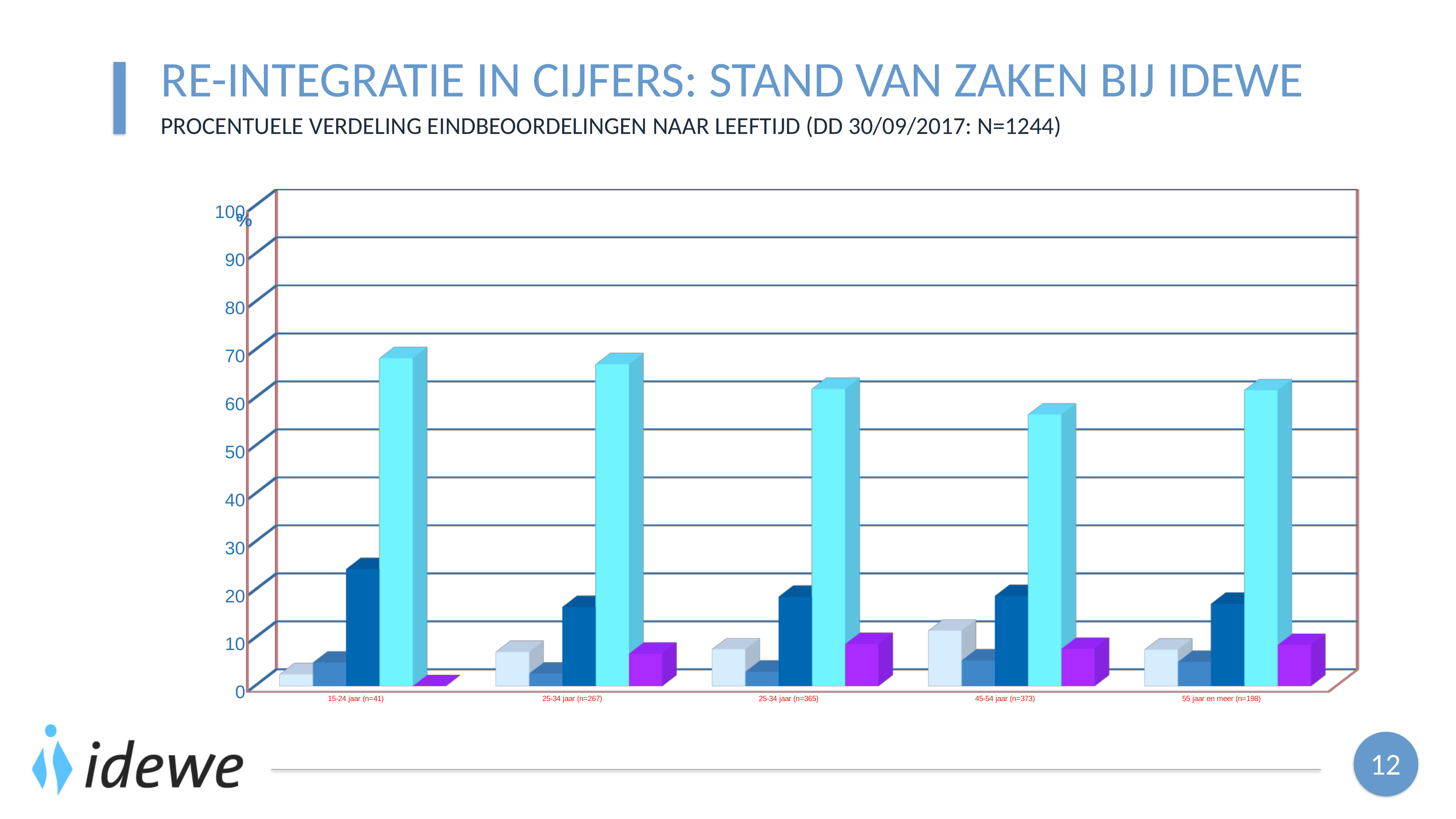
How many bars are plotted for each age category in the chart? 5 Which is larger: the cyan bar for 15-24 jaar (n=41) or the cyan bar for 45-54 jaar (n=373)? 15-24 jaar (n=41) Which age category has the lowest purple bar? 15-24 jaar (n=41) Is the cyan bar for 15-24 jaar (n=41) greater or less than 60? greater How many age categories are shown along the x axis of the chart? 5 Which age category has the lowest cyan (tallest series) bar? 45-54 jaar (n=373) What is the maximum value shown on the chart's vertical axis? 100 Is the purple bar for 25-34 jaar (n=267) greater or less than 10? less Which age category has the highest dark blue bar? 15-24 jaar (n=41) What kind of chart is shown on the slide? bar chart Is the dark blue bar for 15-24 jaar (n=41) greater or less than 20? greater